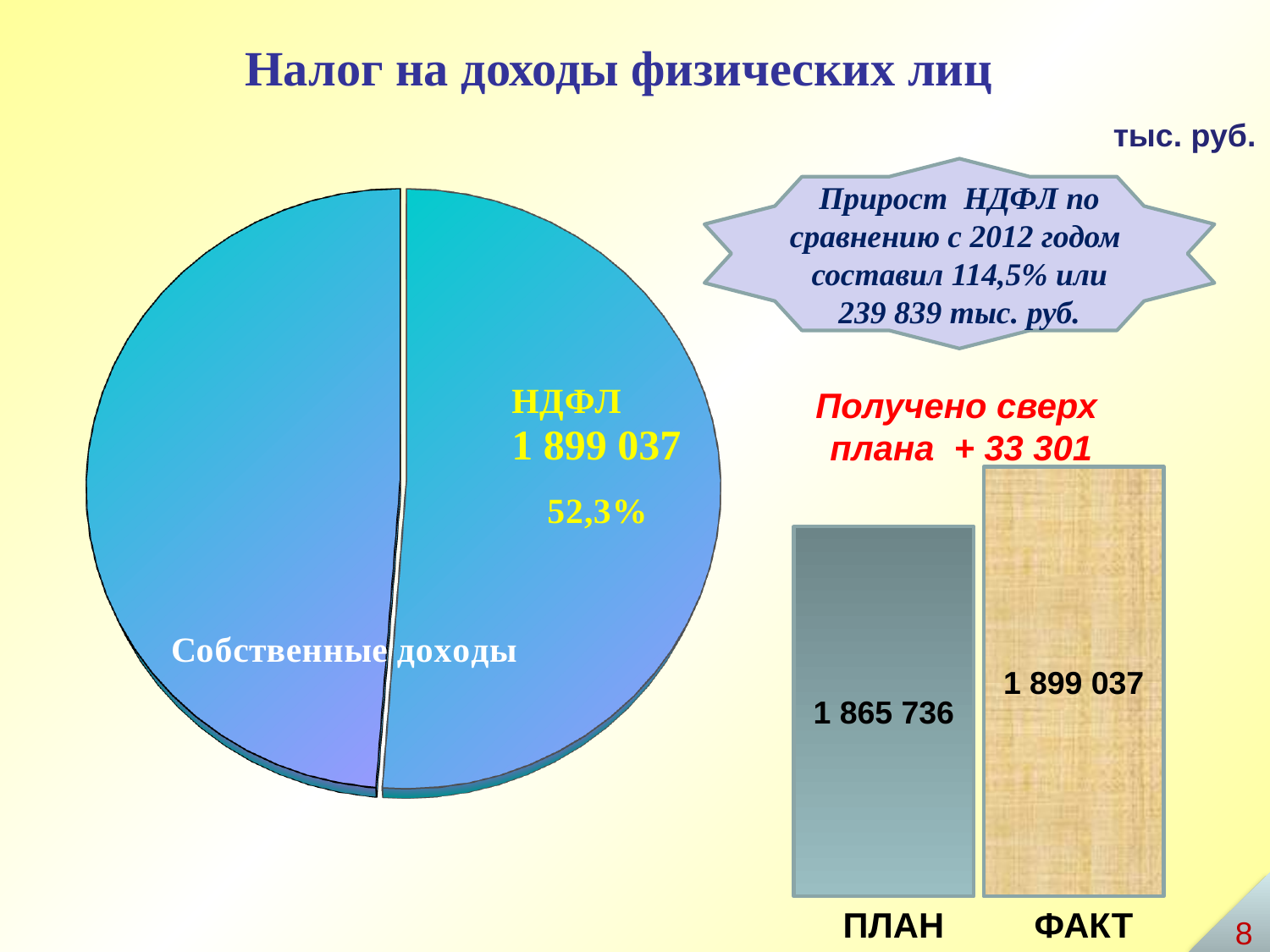
On the pie chart on the left, what share does the НДФЛ slice represent? 52,3% On the pie chart on the left, how many slices are there? 2 What kind of chart is shown on the left of the slide? Pie chart On the bar chart at the bottom right, what is the value for ФАКТ? 1 899 037 What kind of chart is shown at the bottom right of the slide? Bar chart What is the title of the slide? Налог на доходы физических лиц On the bar chart at the bottom right, what is the value for ПЛАН? 1 865 736 On the bar chart at the bottom right, how many bars are shown? 2 On the pie chart on the left, what is the label of the slice other than НДФЛ? Собственные доходы On the pie chart on the left, what value is printed for НДФЛ? 1 899 037 On the bar chart at the bottom right, which bar is higher, ПЛАН or ФАКТ? ФАКТ On the bar chart at the bottom right, by how much does ФАКТ exceed ПЛАН? 33 301